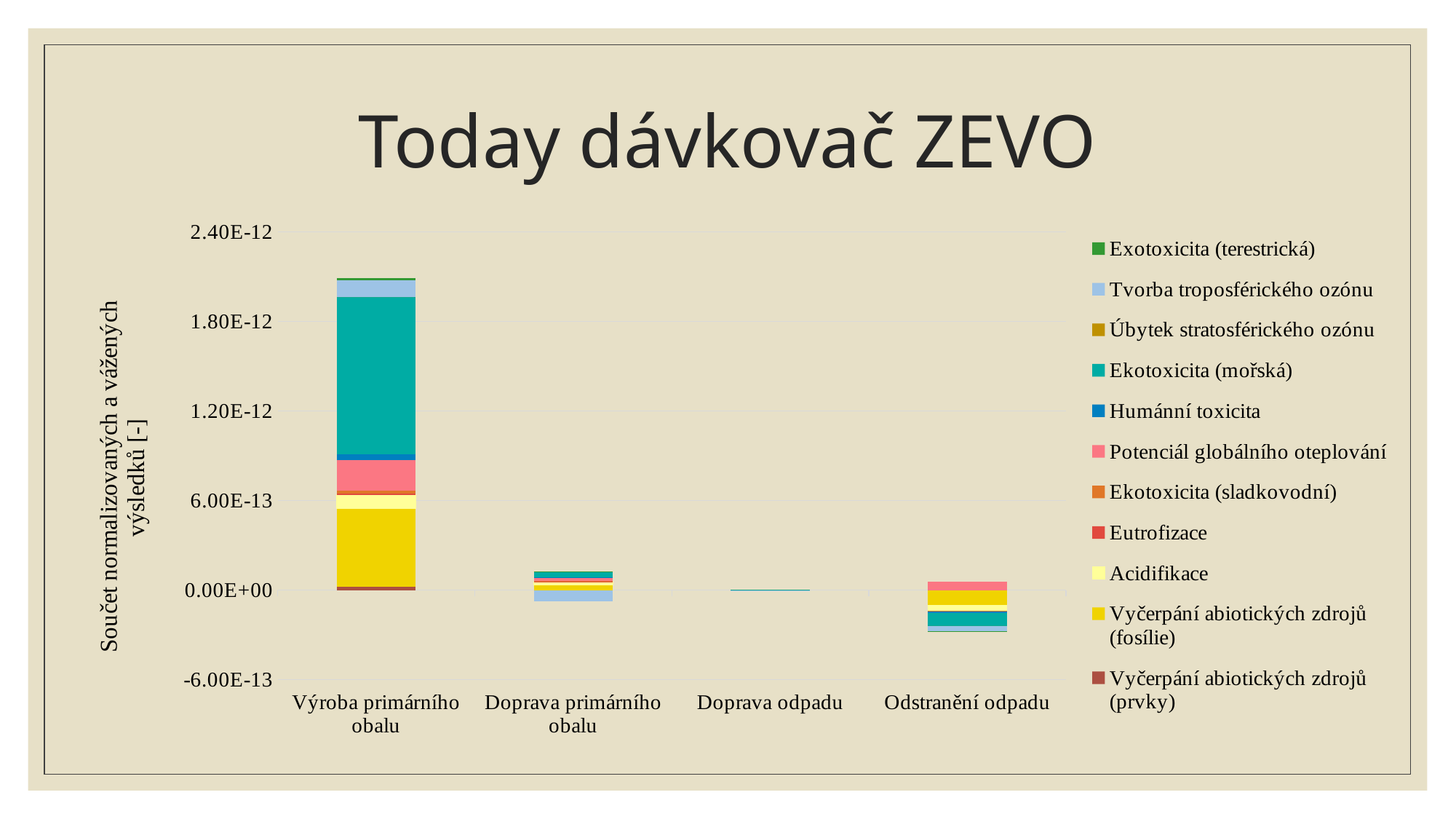
Which category has the smallest visible bar? Doprava odpadu How many categories are shown on the x axis? 4 Which bar is taller, Výroba primárního obalu or Doprava odpadu? Výroba primárního obalu What is the lowest value shown on the y axis? -6.00E-13 What is the label of the y axis? Součet normalizovaných a vážených výsledků [-] What kind of chart is shown on the slide? Stacked bar chart Which category has the tallest stacked bar? Výroba primárního obalu Which category's bar extends furthest below zero? Odstranění odpadu Is the top of the stacked bar for Doprava primárního obalu greater or less than 6.00E-13? less Is the top of the stacked bar for Výroba primárního obalu greater or less than 1.80E-12? greater How many series does the legend list? 11 What is the title of the slide? Today dávkovač ZEVO